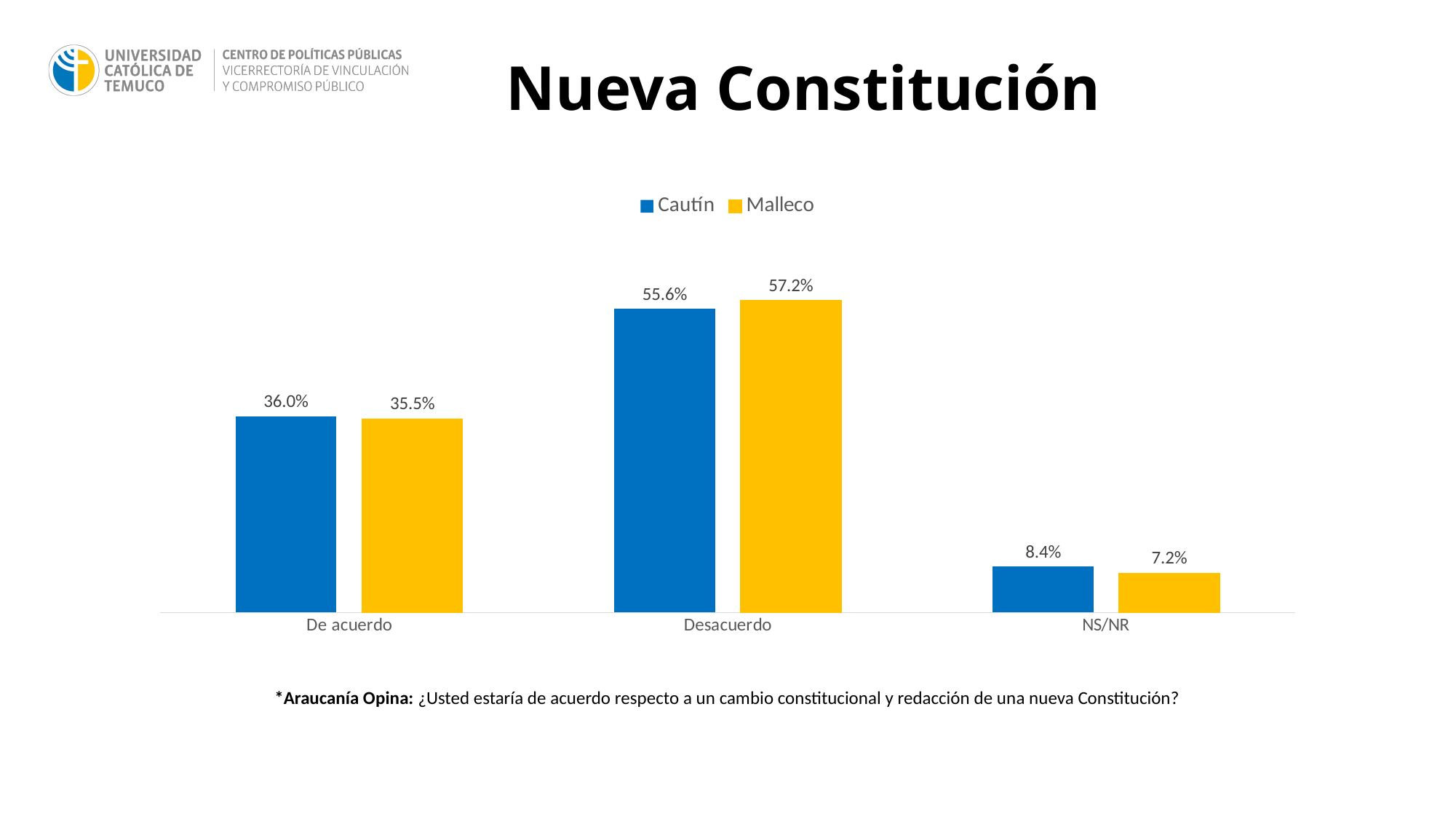
What is the value for Cautín in the NS/NR category? 8.4% Which category has the lowest value for Malleco? NS/NR Which is larger in the Desacuerdo category, Cautín or Malleco? Malleco What is the difference between the Cautín and Malleco values in the NS/NR category? 1.2% Which category has the highest value for Cautín? Desacuerdo What is the difference between the Malleco and Cautín values in the Desacuerdo category? 1.6% What is the value for Cautín in the De acuerdo category? 36.0% How many categories are shown on the x axis? 3 How many series does the legend list? 2 What kind of chart is shown on the slide? Bar chart What is the value for Malleco in the Desacuerdo category? 57.2% What is the value for Malleco in the De acuerdo category? 35.5%